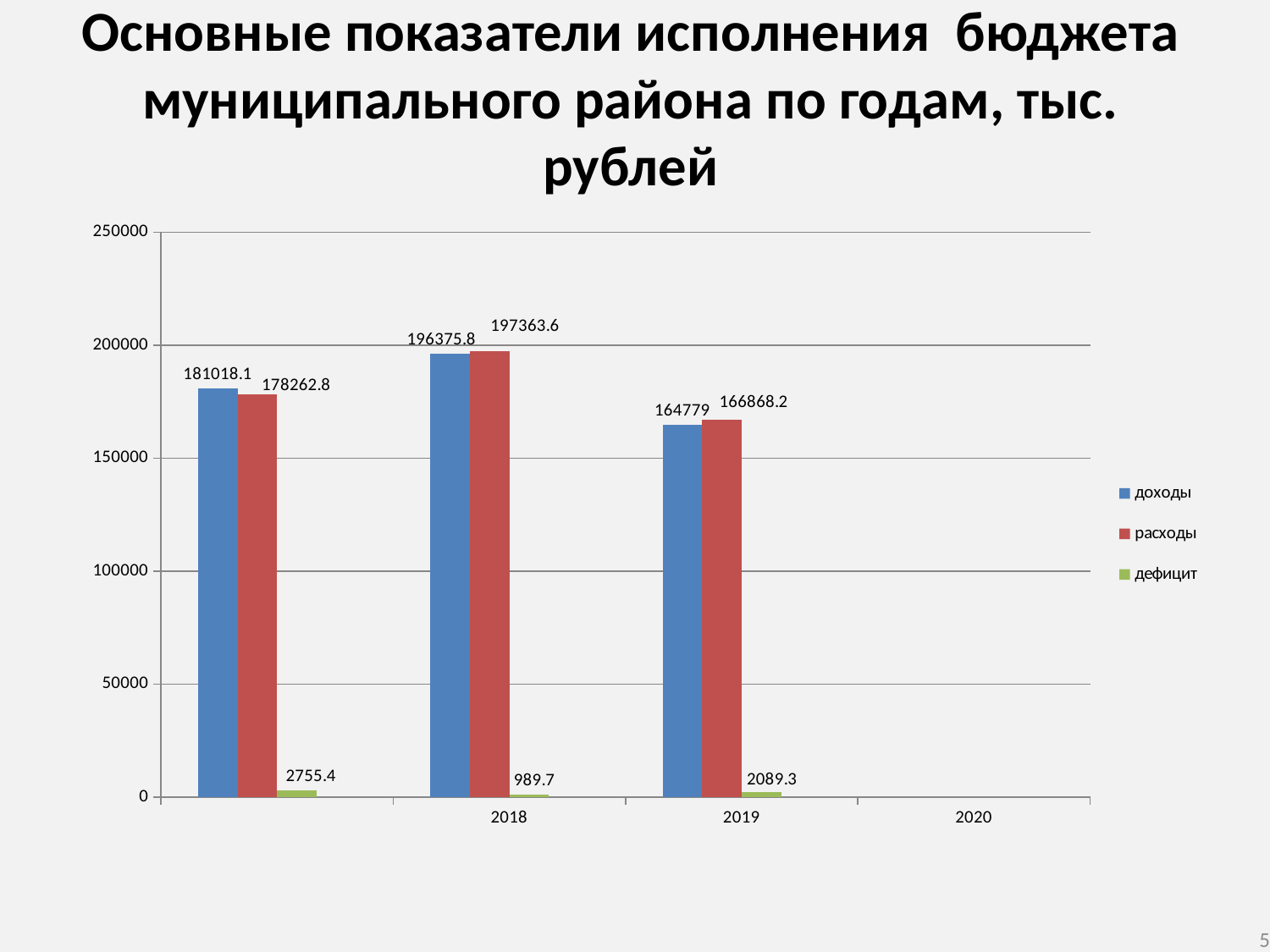
Which year has the larger value of доходы, 2018 or 2019? 2018 What is the value of доходы for 2019? 164779 Which year has the highest value of расходы? 2018 What colour represents дефицит in the chart? green How many series does the legend list? 3 By how much did доходы fall from 2018 to 2019? 31596.8 What is the difference between расходы and доходы in 2018? 987.8 What is the value of расходы for 2019? 166868.2 What is the value of доходы for 2018? 196375.8 Is the value of доходы for 2019 greater or less than 150000? greater What kind of chart is shown on the slide? bar chart What is the value of дефицит for 2018? 989.7